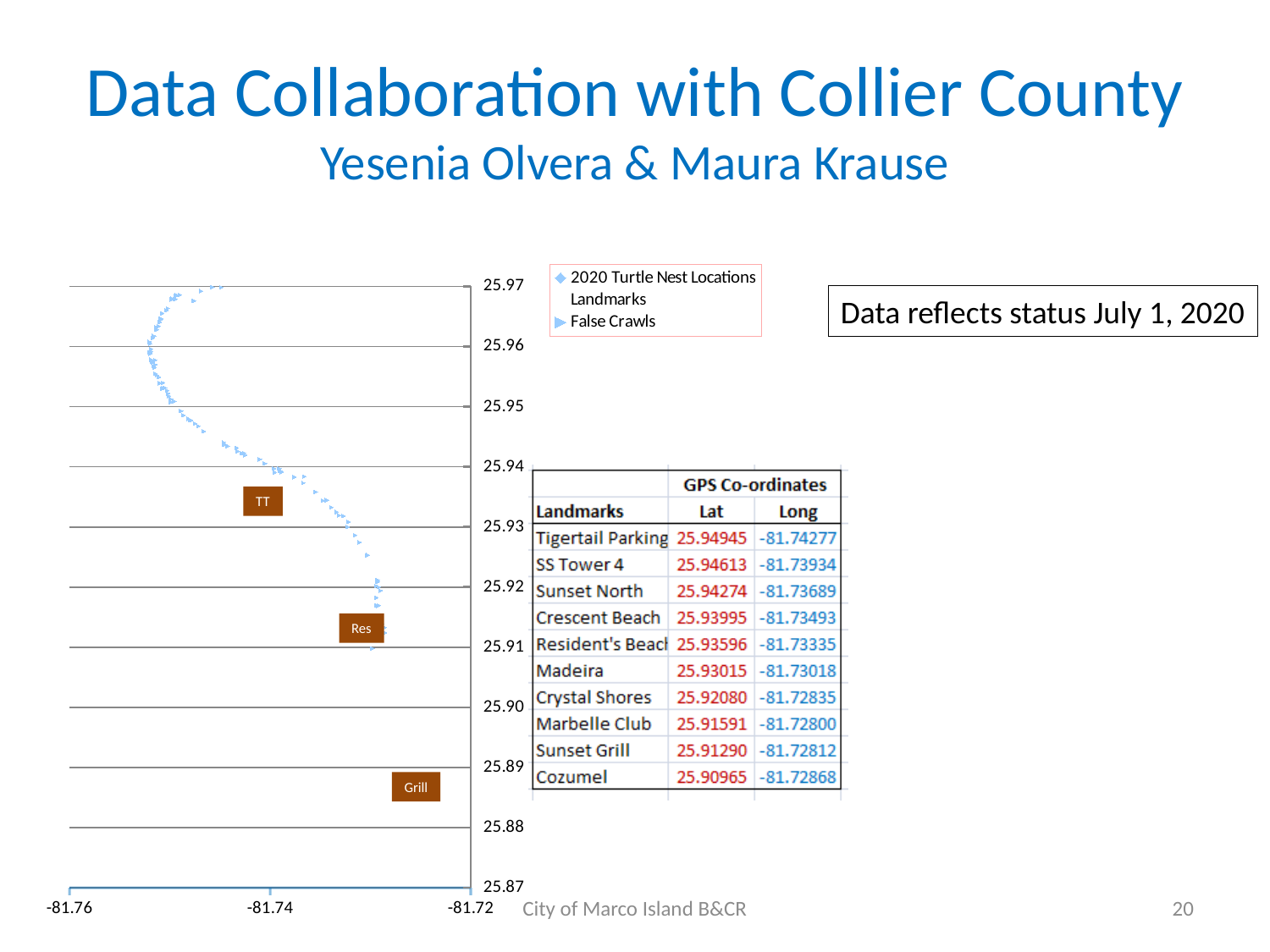
What is the highest value shown on the chart's vertical axis? 25.97 How many series does the chart's legend list? 3 Do the plotted points rise or fall as you move from left to right along the x axis? fall What kind of chart is shown on the slide? scatter chart What are the three entries in the chart's legend? 2020 Turtle Nest Locations, Landmarks, False Crawls